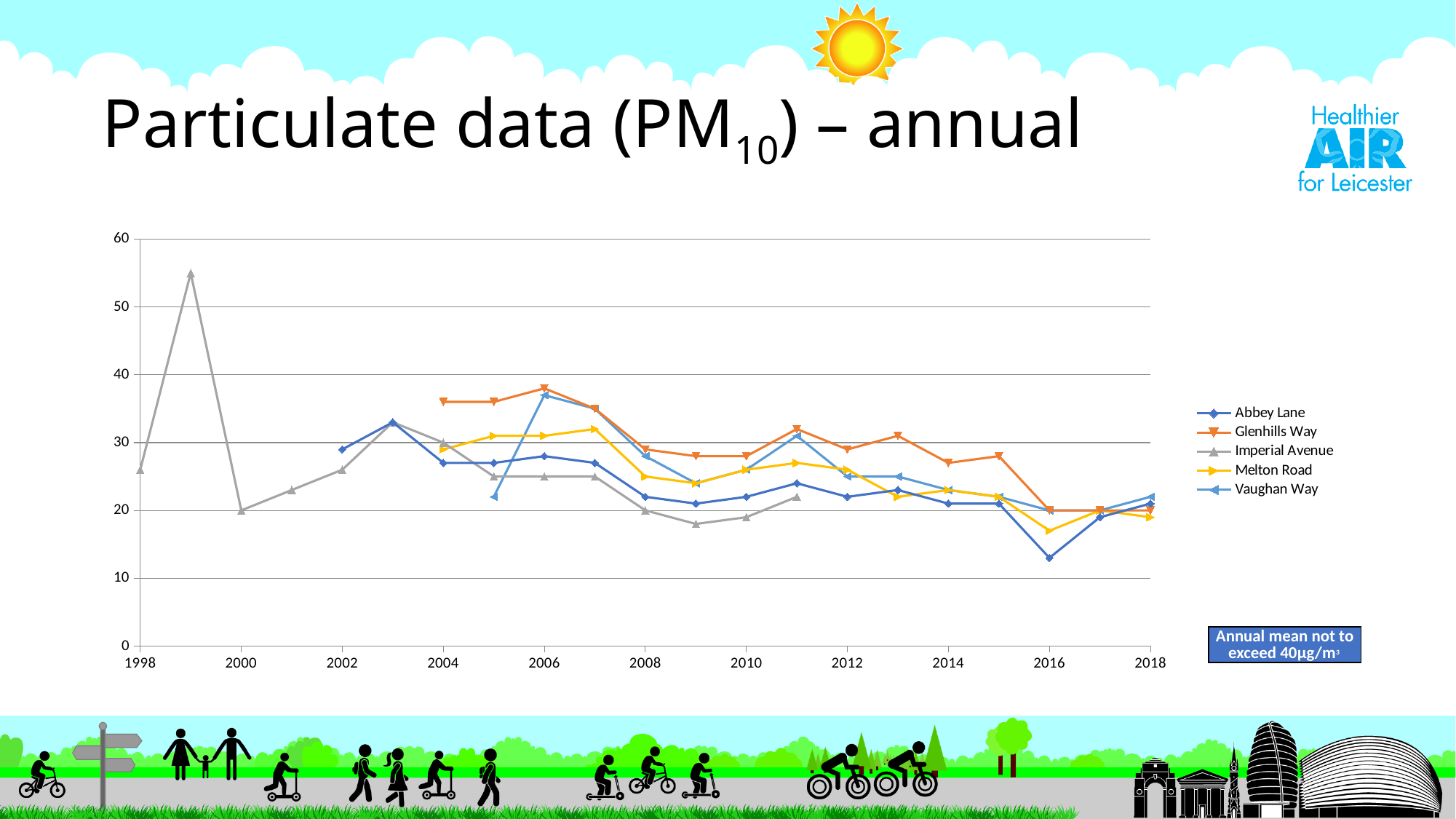
Is the value for Abbey Lane in 2016 greater or less than 20? less Does the Glenhills Way series generally rise or fall between 2006 and 2016? fall Is the value for Imperial Avenue in 1999 greater or less than 50? greater In 2013, which is larger: the value for Glenhills Way or the value for Abbey Lane? Glenhills Way Is the value for Vaughan Way in 2006 greater or less than 30? greater Which series reaches the highest value anywhere on the chart? Imperial Avenue Which series has the lowest value in 2016? Abbey Lane What kind of chart is shown on the slide? line chart What is the first year shown on the x axis? 1998 Which series is listed first in the legend? Abbey Lane How many series does the legend list? 5